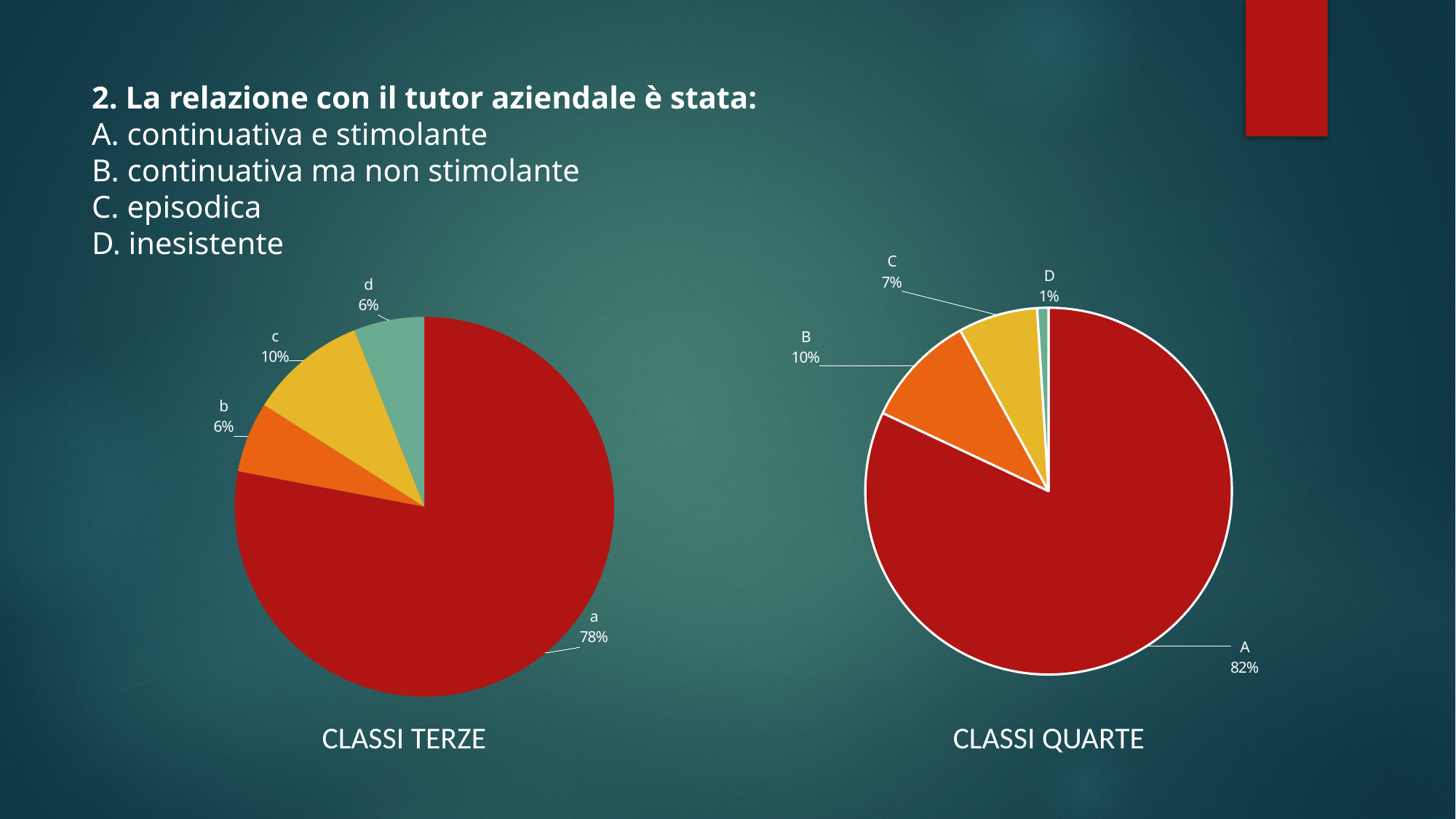
In the CLASSI TERZE chart, what share does slice a have? 78% In the CLASSI QUARTE chart, what is the difference between slice A and slice B? 72% In the CLASSI QUARTE chart, which slice is the smallest? D How many slices does the CLASSI TERZE chart have? 4 What kind of chart is the CLASSI QUARTE chart? pie chart What is the title of the chart on the right? CLASSI QUARTE In the CLASSI QUARTE chart, what share does slice A have? 82% In the CLASSI TERZE chart, what is the combined share of slices b and d? 12% In the CLASSI QUARTE chart, what share does slice D have? 1% In the CLASSI TERZE chart, what share does slice c have? 10% In the CLASSI TERZE chart, which slice is the largest? a In the CLASSI TERZE chart, which is larger, slice c or slice b? c